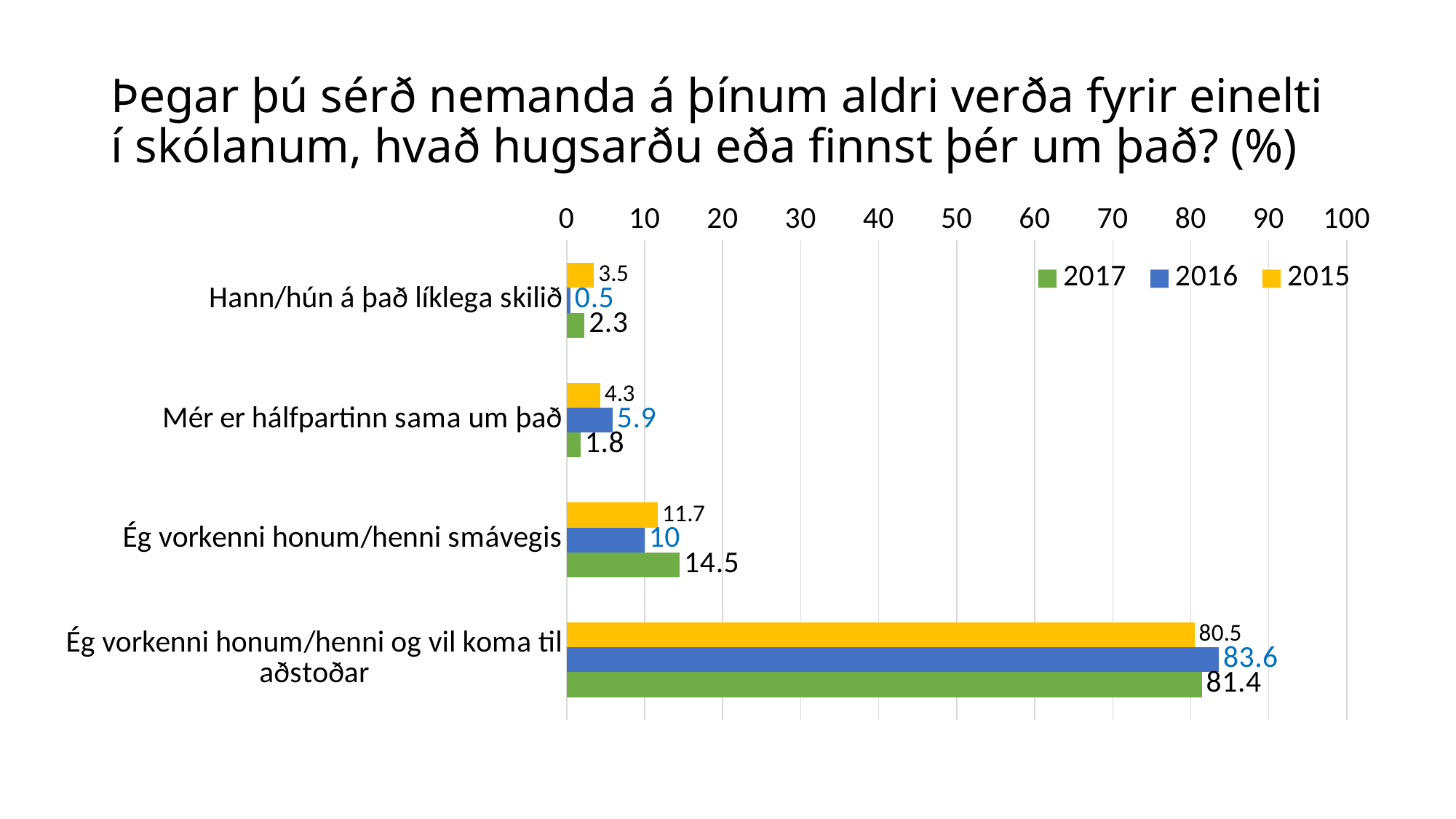
Which colour represents the 2015 series? Yellow What is the difference between the 2016 and 2015 values for "Ég vorkenni honum/henni og vil koma til aðstoðar"? 3.1 What is the 2017 value for "Ég vorkenni honum/henni og vil koma til aðstoðar"? 81.4 Which category has the lowest 2017 value? Mér er hálfpartinn sama um það For "Ég vorkenni honum/henni smávegis", which year has the larger value, 2017 or 2015? 2017 What is the 2015 value for "Mér er hálfpartinn sama um það"? 4.3 How many categories are shown on the chart? 4 What is the 2016 value for "Hann/hún á það líklega skilið"? 0.5 Which category has the highest 2016 value? Ég vorkenni honum/henni og vil koma til aðstoðar How many series does the legend list? 3 What kind of chart is shown on the slide? Bar chart What is the 2016 value for "Ég vorkenni honum/henni smávegis"? 10